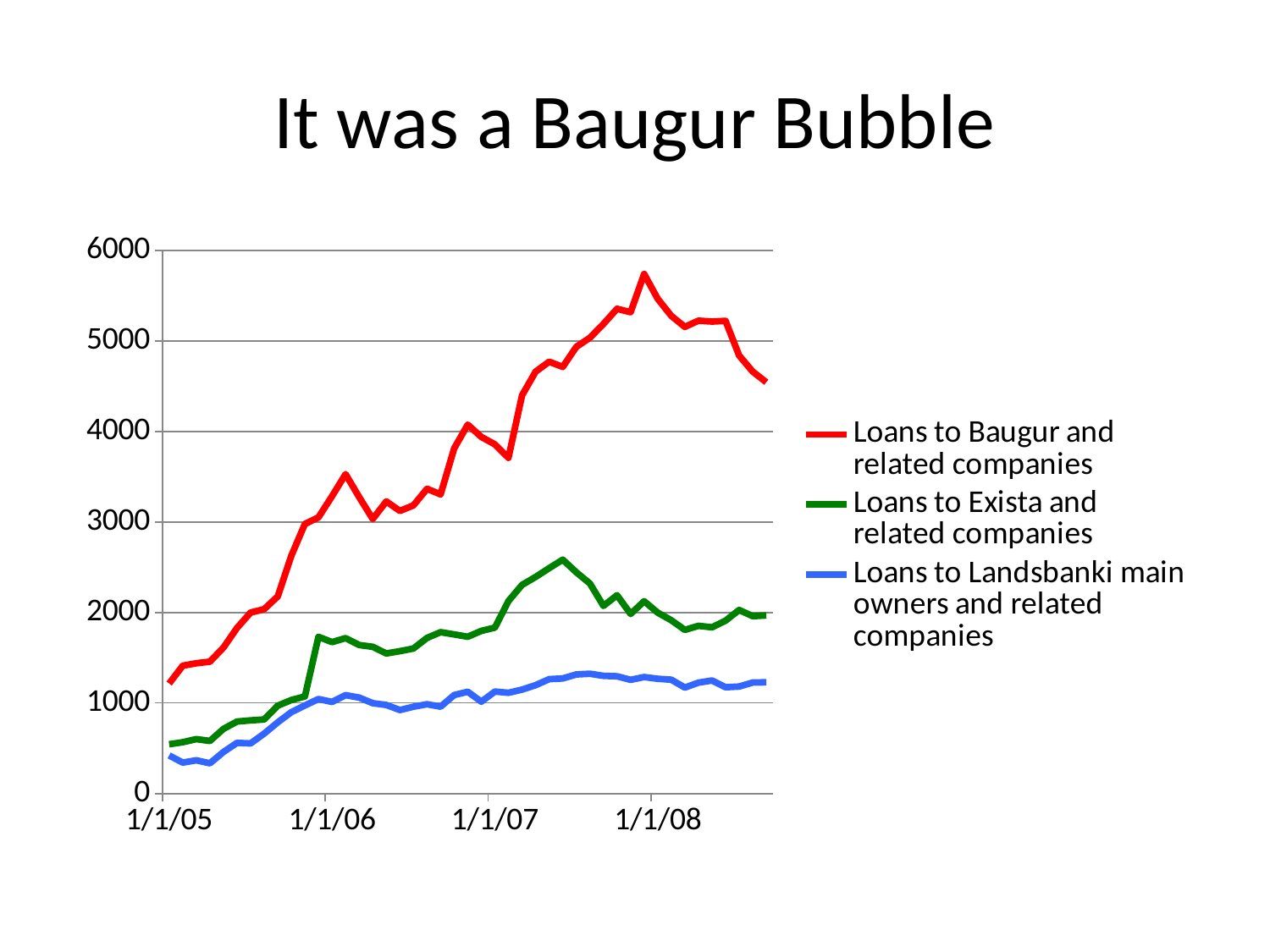
Is the peak value of Loans to Baugur and related companies greater or less than 5000? greater What kind of chart is shown on the slide? line chart At 1/1/06, which is larger: Loans to Exista and related companies or Loans to Landsbanki main owners and related companies? Loans to Exista and related companies Which series has the highest values at 1/1/08? Loans to Baugur and related companies Is the value for Loans to Exista and related companies at 1/1/05 greater or less than 1000? less What is the title of the slide's chart? It was a Baugur Bubble Is the value for Loans to Landsbanki main owners and related companies at 1/1/08 greater or less than 2000? less Which series has the lowest values at 1/1/08? Loans to Landsbanki main owners and related companies Do the values for Loans to Baugur and related companies rise or fall between 1/1/05 and 1/1/07? rise How many series does the legend list? 3 What colour is the line for Loans to Exista and related companies? green